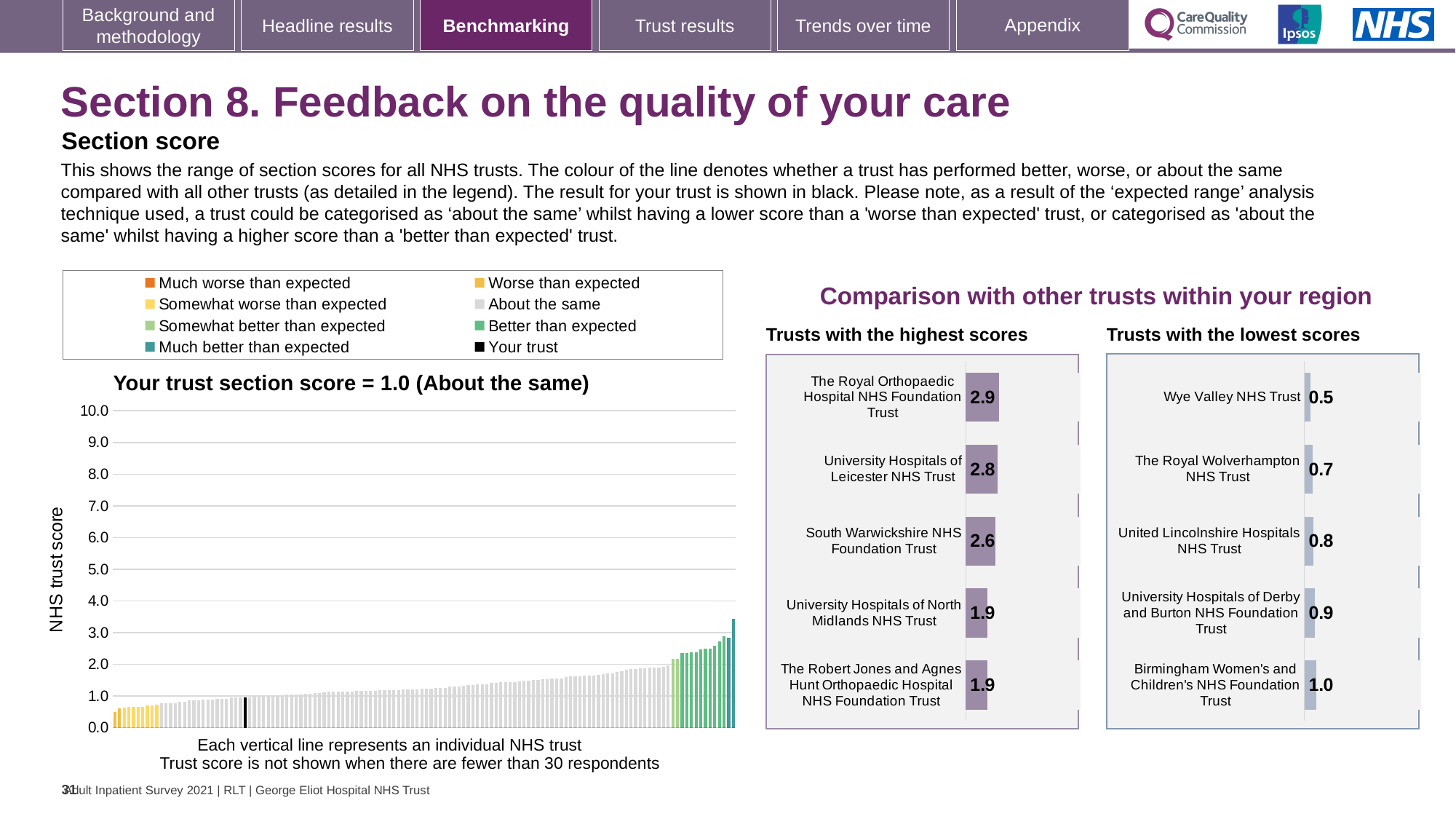
In the 'Trusts with the lowest scores' chart, what is the score for United Lincolnshire Hospitals NHS Trust? 0.8 In the 'Trusts with the lowest scores' chart, which trust has the lowest score? Wye Valley NHS Trust In the 'Trusts with the highest scores' chart, what is the difference between the scores of The Royal Orthopaedic Hospital NHS Foundation Trust and South Warwickshire NHS Foundation Trust? 0.3 In the 'Trusts with the highest scores' chart, which trust has the highest score? The Royal Orthopaedic Hospital NHS Foundation Trust In the 'Trusts with the lowest scores' chart, what is the score for Wye Valley NHS Trust? 0.5 In the 'Your trust section score' chart, what is the section score for your trust? 1.0 In the 'Trusts with the highest scores' chart, what is the score for The Royal Orthopaedic Hospital NHS Foundation Trust? 2.9 How many trusts are shown in the 'Trusts with the lowest scores' chart? 5 In the 'Trusts with the highest scores' chart, what is the score for South Warwickshire NHS Foundation Trust? 2.6 In the 'Trusts with the lowest scores' chart, which has the larger score: The Royal Wolverhampton NHS Trust or University Hospitals of Derby and Burton NHS Foundation Trust? University Hospitals of Derby and Burton NHS Foundation Trust How many entries does the legend above the 'Your trust section score' chart list? 8 In the 'Your trust section score' chart, do the trust scores rise or fall from left to right? rise